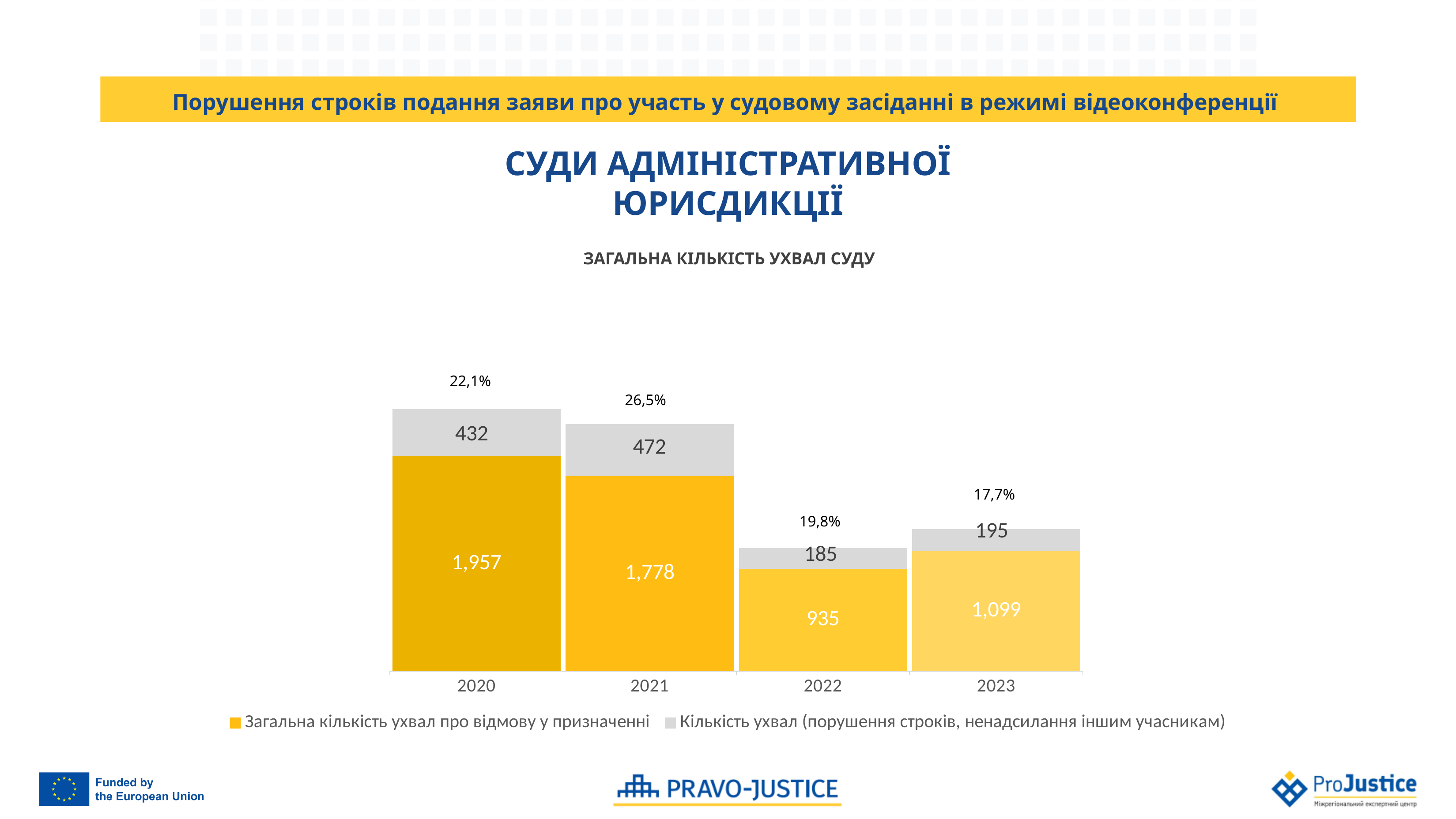
What type of chart is shown on the slide? Stacked bar chart What is the total of the stacked bar for 2022? 1,120 Which year has the lowest value for 'Кількість ухвал (порушення строків, ненадсилання іншим учасникам)'? 2022 Which year has the highest value for 'Загальна кількість ухвал про відмову у призначенні'? 2020 What is the value of 'Загальна кількість ухвал про відмову у призначенні' for 2020? 1,957 How many years are shown on the x axis of the chart? 4 What is the subtitle printed directly above the chart? ЗАГАЛЬНА КІЛЬКІСТЬ УХВАЛ СУДУ What is the value of 'Кількість ухвал (порушення строків, ненадсилання іншим учасникам)' for 2021? 472 What percentage is shown above the bar for 2023? 17,7% What is the difference between the 'Загальна кількість ухвал про відмову у призначенні' values for 2020 and 2021? 179 Which is larger: the 'Кількість ухвал (порушення строків, ненадсилання іншим учасникам)' value for 2022 or for 2023? 2023 How many series does the chart legend list? 2